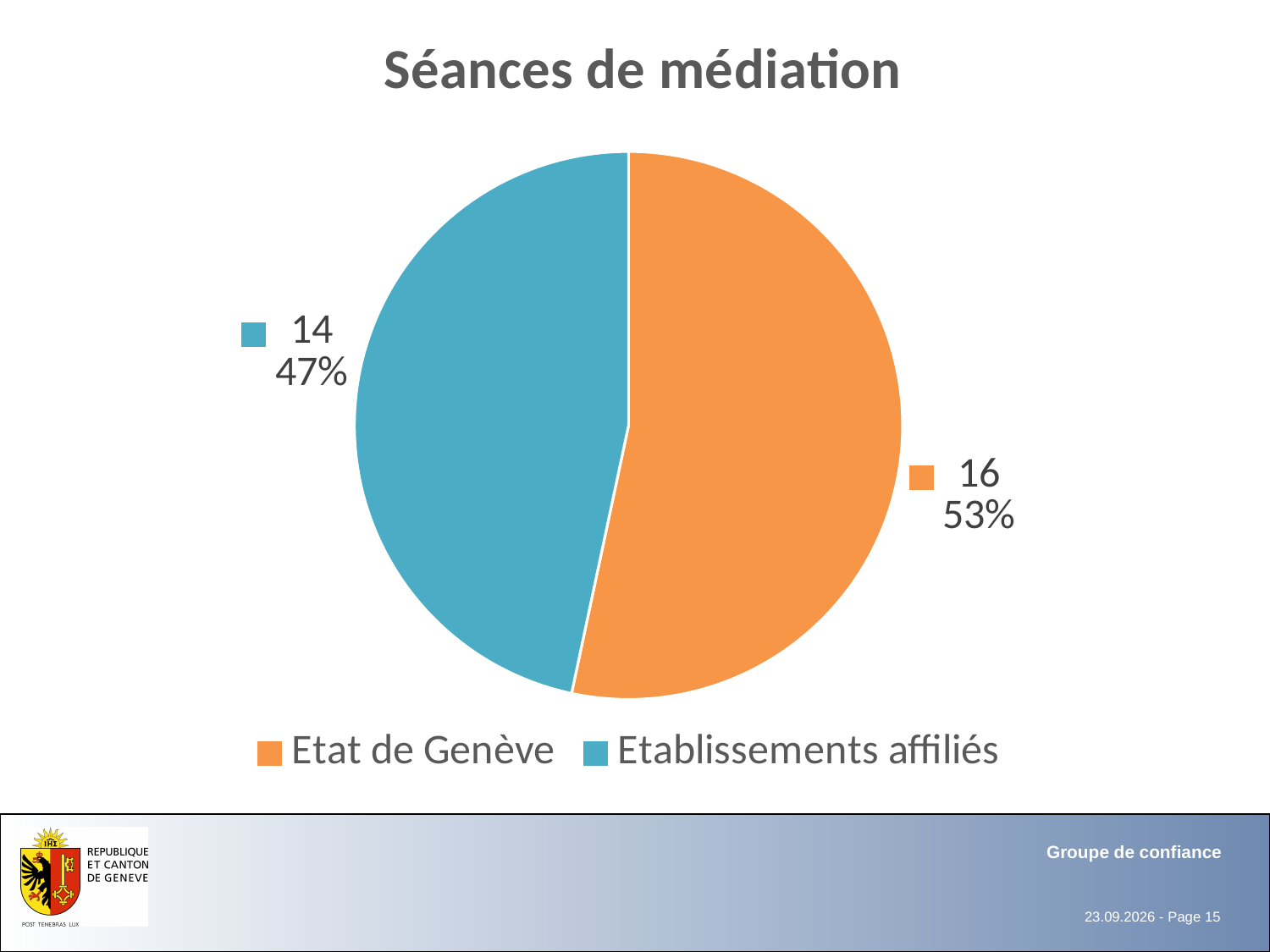
What is the title of the chart? Séances de médiation What kind of chart is shown? pie chart Which category has the smallest slice? Etablissements affiliés What is the value for Etablissements affiliés? 14 What is the value for Etat de Genève? 16 What percentage share does Etat de Genève have? 53% What is the total of the two values shown in the pie chart? 30 What is the difference between the values for Etat de Genève and Etablissements affiliés? 2 What percentage share does Etablissements affiliés have? 47% Which category has the largest slice? Etat de Genève Which is larger, Etat de Genève or Etablissements affiliés? Etat de Genève How many categories does the pie chart show? 2